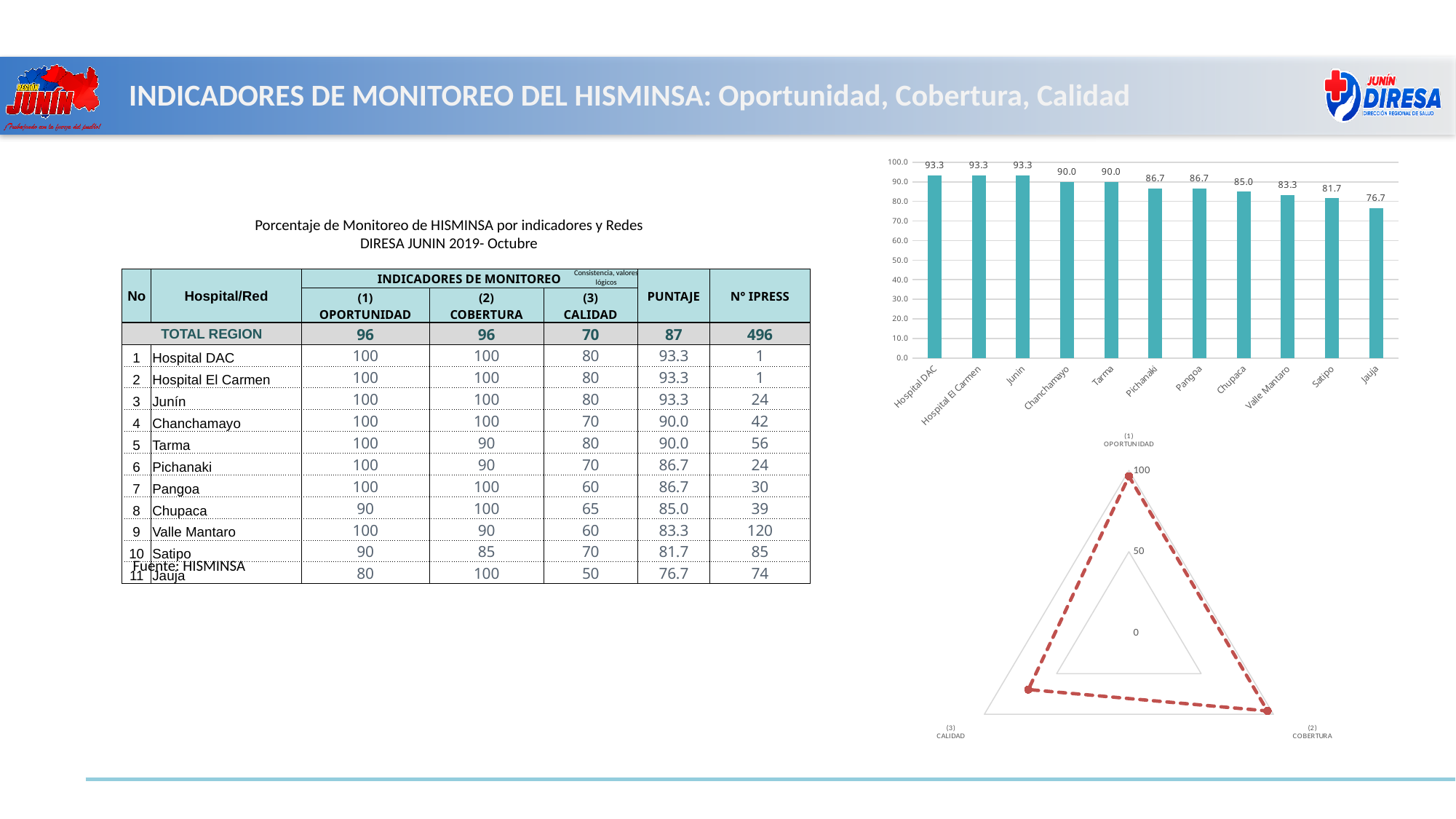
In the bar chart at the top right, which is larger, the value for Tarma or the value for Pangoa? Tarma In the bar chart at the top right, do the values rise or fall from left to right along the x axis? fall In the bar chart at the top right, what is the value for Chupaca? 85.0 In the bar chart at the top right, what is the difference between the values for Hospital DAC and Satipo? 11.6 In the bar chart at the top right, what is the value for Valle Mantaro? 83.3 How many categories are shown in the bar chart at the top right? 11 In the radar chart at the bottom right, is the value for (3) CALIDAD greater or less than 50? greater What kind of chart is shown at the top right of the slide? bar chart What kind of chart is shown at the bottom right of the slide? radar chart In the bar chart at the top right, is the value for Pichanaki greater or less than 80.0? greater In the bar chart at the top right, what is the value for Jauja? 76.7 In the bar chart at the top right, which category has the lowest value? Jauja